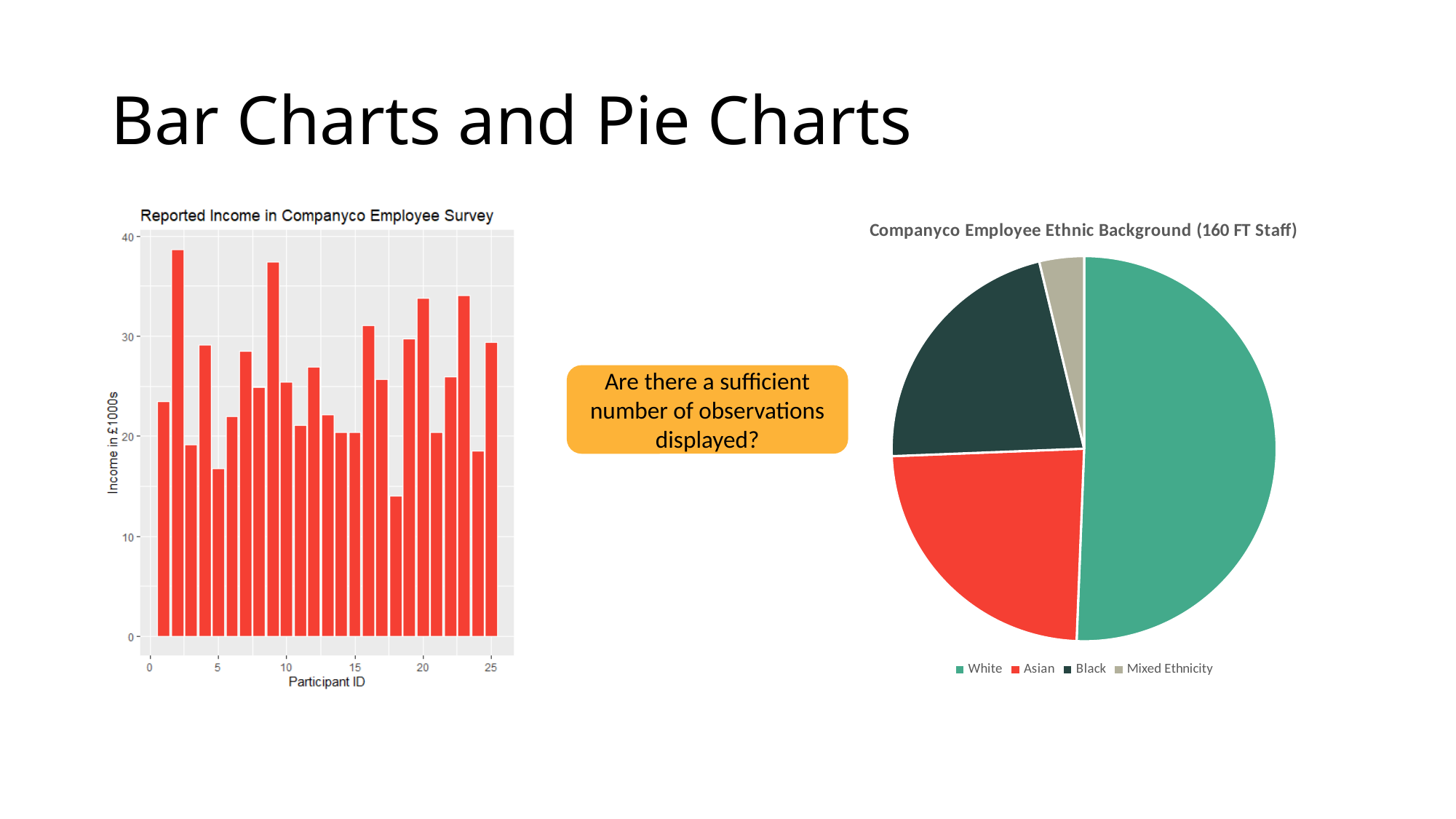
In the 'Reported Income in Companyco Employee Survey' chart, which Participant ID has the highest reported income? 2 In the 'Companyco Employee Ethnic Background (160 FT Staff)' pie chart, which category has the largest slice? White In the 'Reported Income in Companyco Employee Survey' chart, is the value for Participant ID 5 greater or less than 20? less In the 'Reported Income in Companyco Employee Survey' chart, is the value for Participant ID 2 greater or less than 30? greater In the 'Companyco Employee Ethnic Background (160 FT Staff)' pie chart, how many categories does the legend list? 4 What kind of chart is the one on the left of the slide, titled 'Reported Income in Companyco Employee Survey'? bar chart In the 'Reported Income in Companyco Employee Survey' chart, which Participant ID has the lowest reported income? 18 In the 'Reported Income in Companyco Employee Survey' chart, what is the label on the y axis? Income in £1000s In the 'Reported Income in Companyco Employee Survey' chart, is the value for Participant ID 18 greater or less than 20? less What kind of chart is the one on the right of the slide, titled 'Companyco Employee Ethnic Background (160 FT Staff)'? pie chart In the 'Reported Income in Companyco Employee Survey' chart, how many participants (bars) are plotted? 25 In the 'Companyco Employee Ethnic Background (160 FT Staff)' pie chart, which category has the smallest slice? Mixed Ethnicity